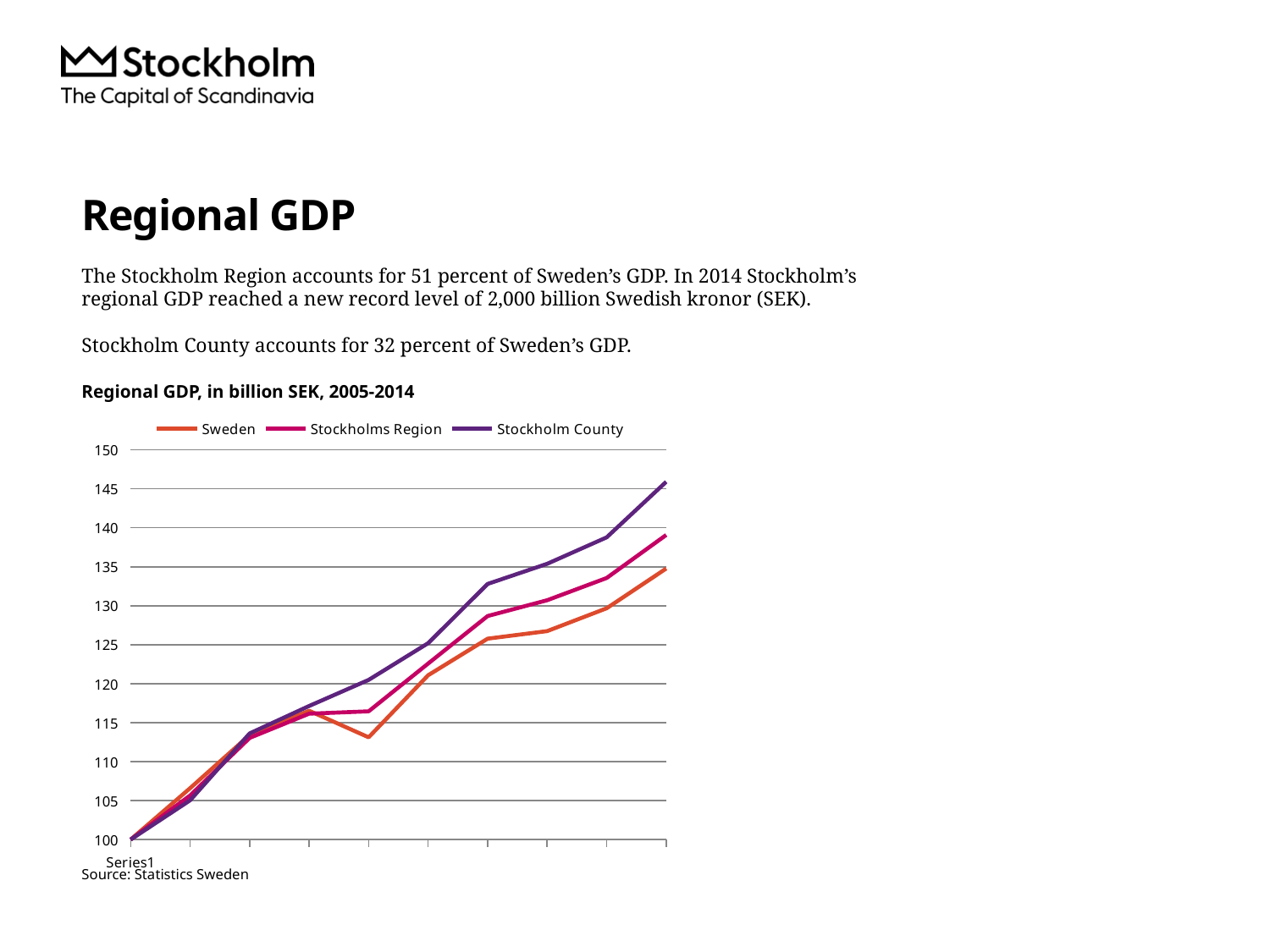
Which series is drawn in purple? Stockholm County At the last point on the chart, which is larger: Stockholm County or Sweden? Stockholm County What kind of chart is shown on the slide? line chart Which series has the lowest value at the last point on the chart? Sweden What is the value of all three series at the first point on the chart? 100 Is the value for Sweden at the last point greater or less than 140? less Is the value for Stockholms Region at the last point greater or less than 135? greater Is the value for Stockholm County at the last point greater or less than 140? greater Which series has the highest value at the last point on the chart? Stockholm County How many series does the chart legend list? 3 Do the values for Stockholm County rise or fall overall along the x axis? rise What is the title of the chart? Regional GDP, in billion SEK, 2005-2014